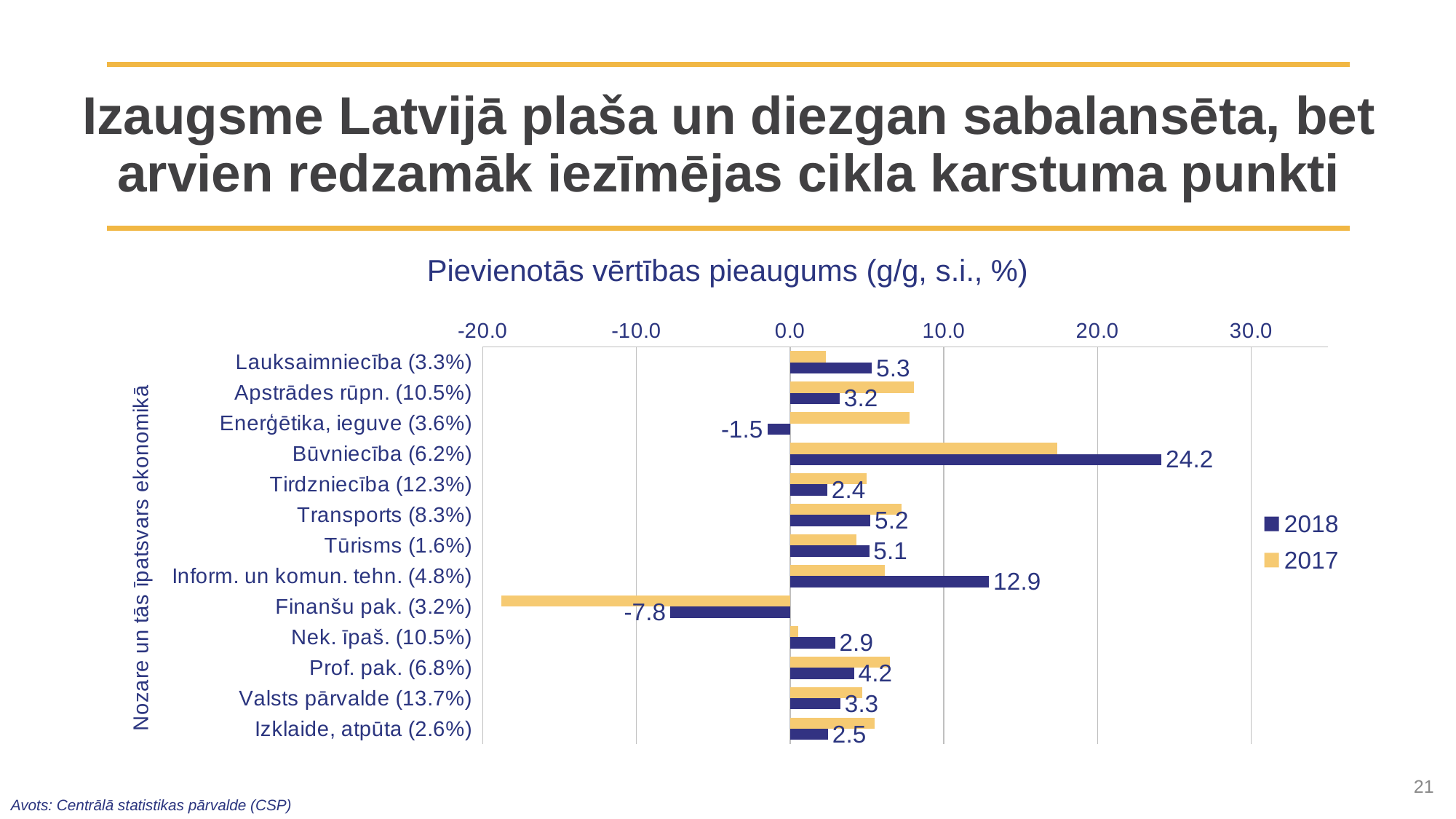
What is the difference between the 2018 values for Būvniecība (6.2%) and Inform. un komun. tehn. (4.8%)? 11.3 What is the 2018 value for Inform. un komun. tehn. (4.8%)? 12.9 What is the 2018 value for Finanšu pak. (3.2%)? -7.8 What is the 2018 value for Būvniecība (6.2%)? 24.2 What is the 2018 value for Enerģētika, ieguve (3.6%)? -1.5 What type of chart is shown on the slide? bar chart Which category has the highest 2018 value? Būvniecība (6.2%) Which category has the lowest 2018 value? Finanšu pak. (3.2%) Which has the larger 2018 value, Lauksaimniecība (3.3%) or Tirdzniecība (12.3%)? Lauksaimniecība (3.3%) How many series does the legend list? 2 Is the 2017 value for Finanšu pak. (3.2%) greater or less than -10.0? less How many categories are shown on the chart? 13